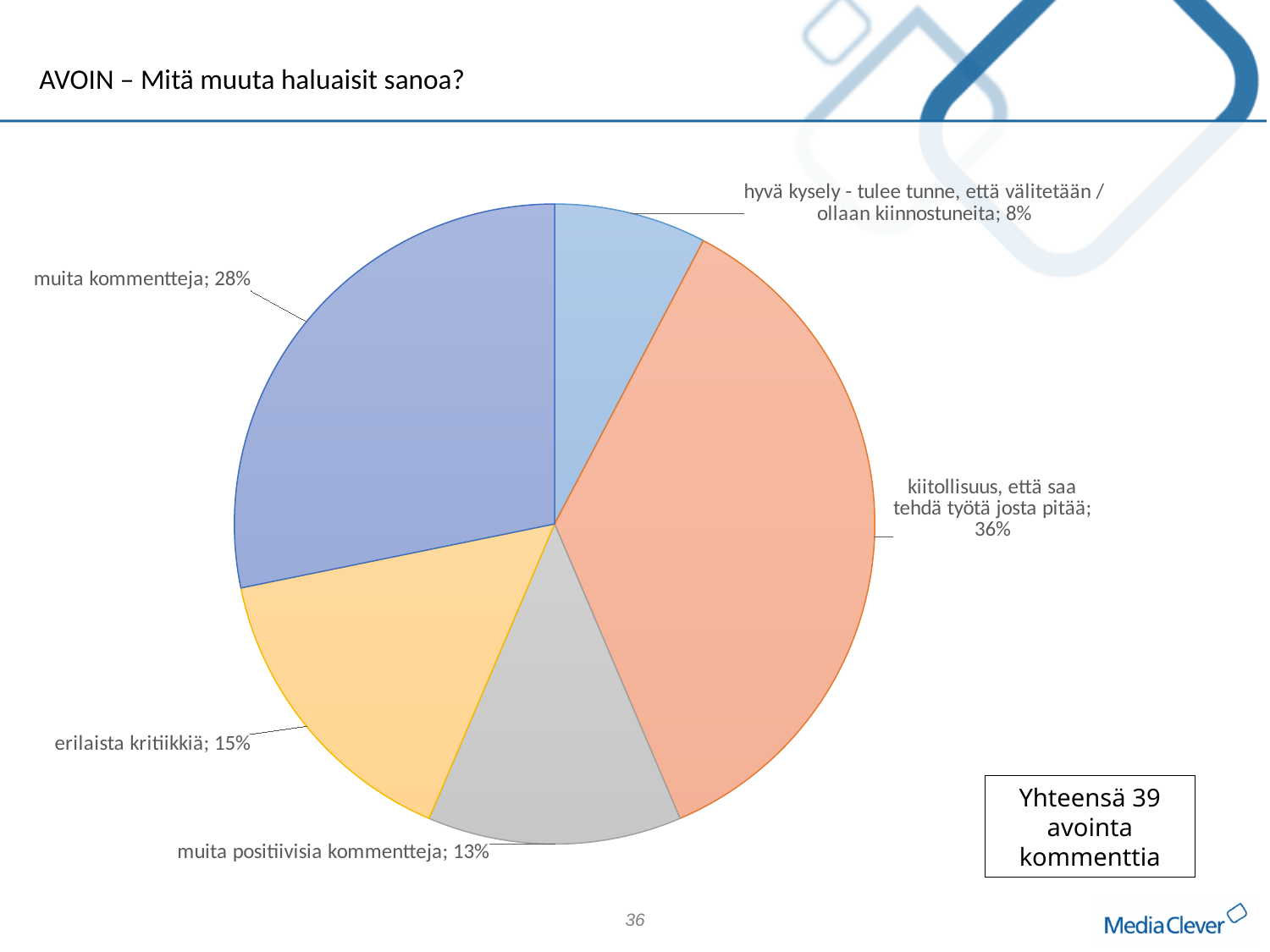
Which category has the smallest slice of the pie? hyvä kysely - tulee tunne, että välitetään / ollaan kiinnostuneita What is the value for "muita positiivisia kommentteja"? 13% What is the difference in percentage points between "kiitollisuus, että saa tehdä työtä josta pitää" and "muita kommentteja"? 8 Which category has the largest slice of the pie? kiitollisuus, että saa tehdä työtä josta pitää Which is larger, "erilaista kritiikkiä" or "muita positiivisia kommentteja"? erilaista kritiikkiä What share of the pie does "kiitollisuus, että saa tehdä työtä josta pitää" have? 36% What is the value for "muita kommentteja"? 28% What kind of chart is shown on the slide? pie chart How many slices does the pie chart have? 5 According to the text box on the slide, how many open comments were there in total? 39 What is the value for "erilaista kritiikkiä"? 15% What is the value for "hyvä kysely - tulee tunne, että välitetään / ollaan kiinnostuneita"? 8%